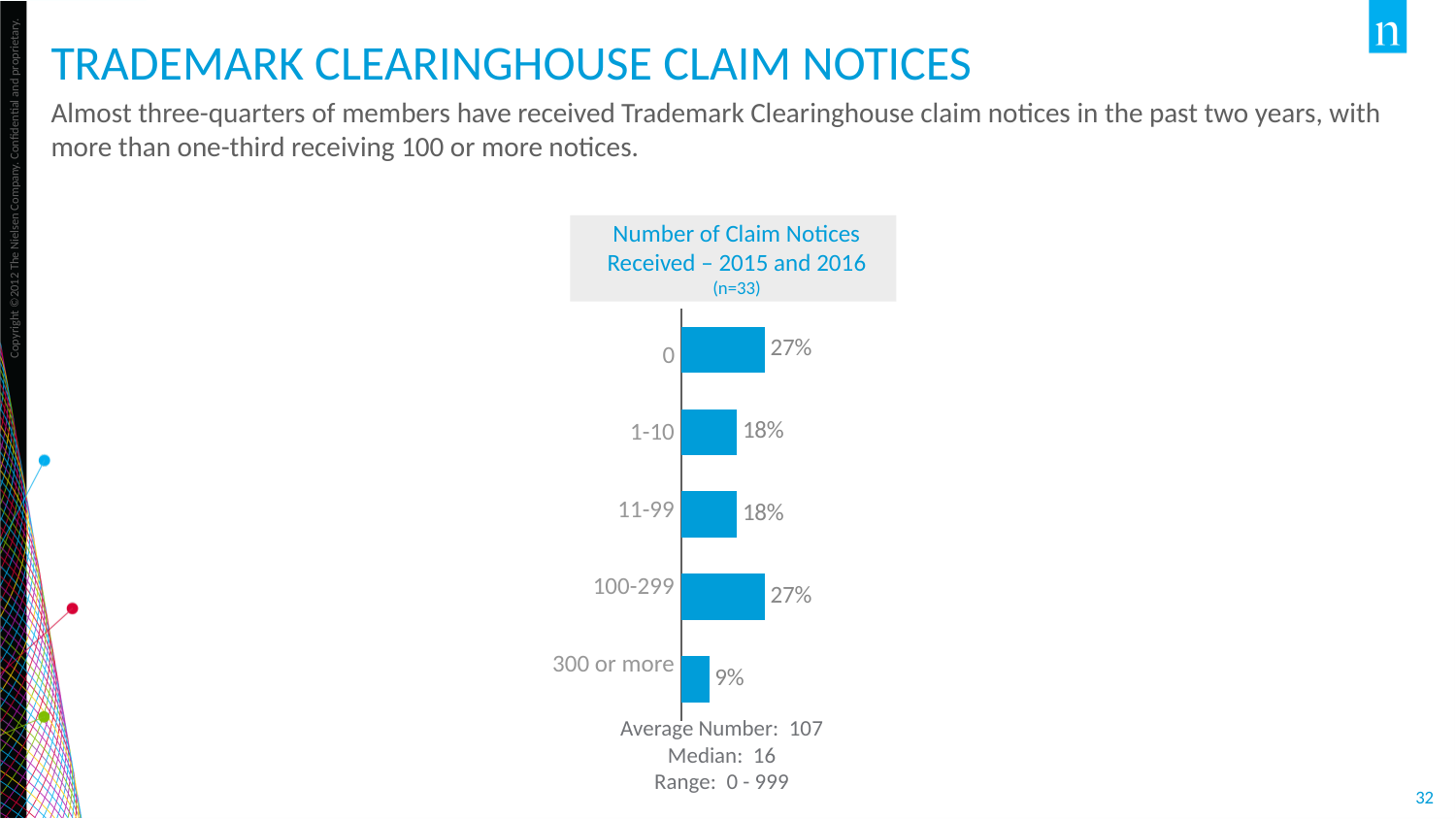
What is the difference in percentage points between the 0 category and the 11-99 category? 9 What percentage of members received 100-299 claim notices? 27% Which is larger, the value for 0 or the value for 1-10? 0 How many categories are shown in the chart? 5 What percentage of members received 0 claim notices? 27% What kind of chart is shown on the slide? Bar chart What percentage of members received 300 or more claim notices? 9% What is the title of the chart? Number of Claim Notices Received – 2015 and 2016 What is the sample size (n) shown under the chart title? 33 Which category has the lowest percentage? 300 or more What percentage of members received 1-10 claim notices? 18% What is the difference in percentage points between the 100-299 category and the 300 or more category? 18